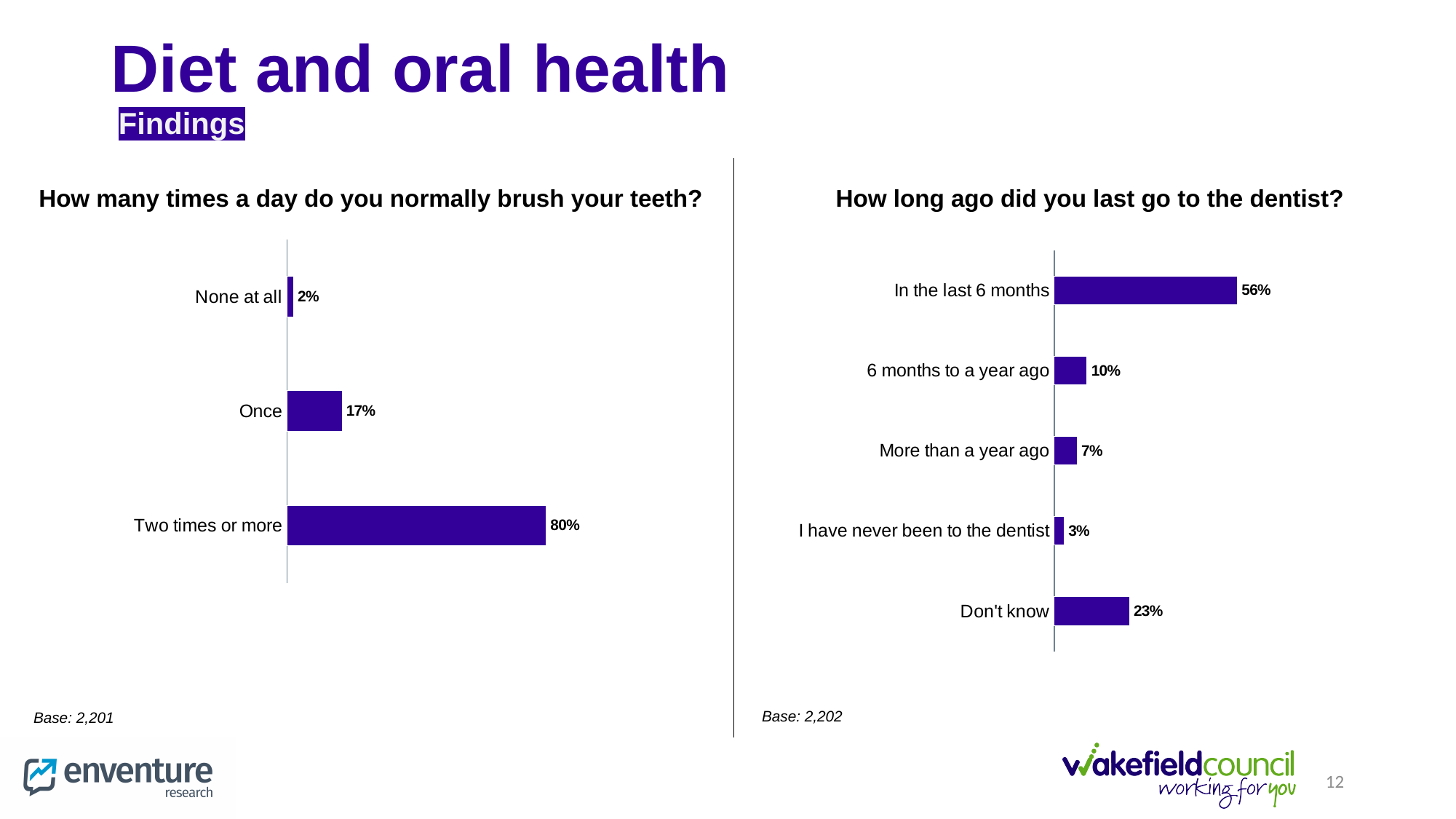
In the chart 'How many times a day do you normally brush your teeth?', what is the value for 'Once'? 17% What kind of chart is 'How long ago did you last go to the dentist?'? Bar chart In the chart 'How long ago did you last go to the dentist?', what is the value for 'In the last 6 months'? 56% In the chart 'How many times a day do you normally brush your teeth?', what is the difference between 'Two times or more' and 'Once'? 63% In the chart 'How many times a day do you normally brush your teeth?', which category has the lowest value? None at all In the chart 'How long ago did you last go to the dentist?', which is larger: '6 months to a year ago' or 'More than a year ago'? 6 months to a year ago In the chart 'How many times a day do you normally brush your teeth?', what is the value for 'Two times or more'? 80% In the chart 'How long ago did you last go to the dentist?', which category has the lowest value? I have never been to the dentist In the chart 'How long ago did you last go to the dentist?', what is the value for 'Don't know'? 23% In the chart 'How many times a day do you normally brush your teeth?', how many categories are shown? 3 In the chart 'How long ago did you last go to the dentist?', how many categories are shown? 5 In the chart 'How long ago did you last go to the dentist?', which category has the highest value? In the last 6 months